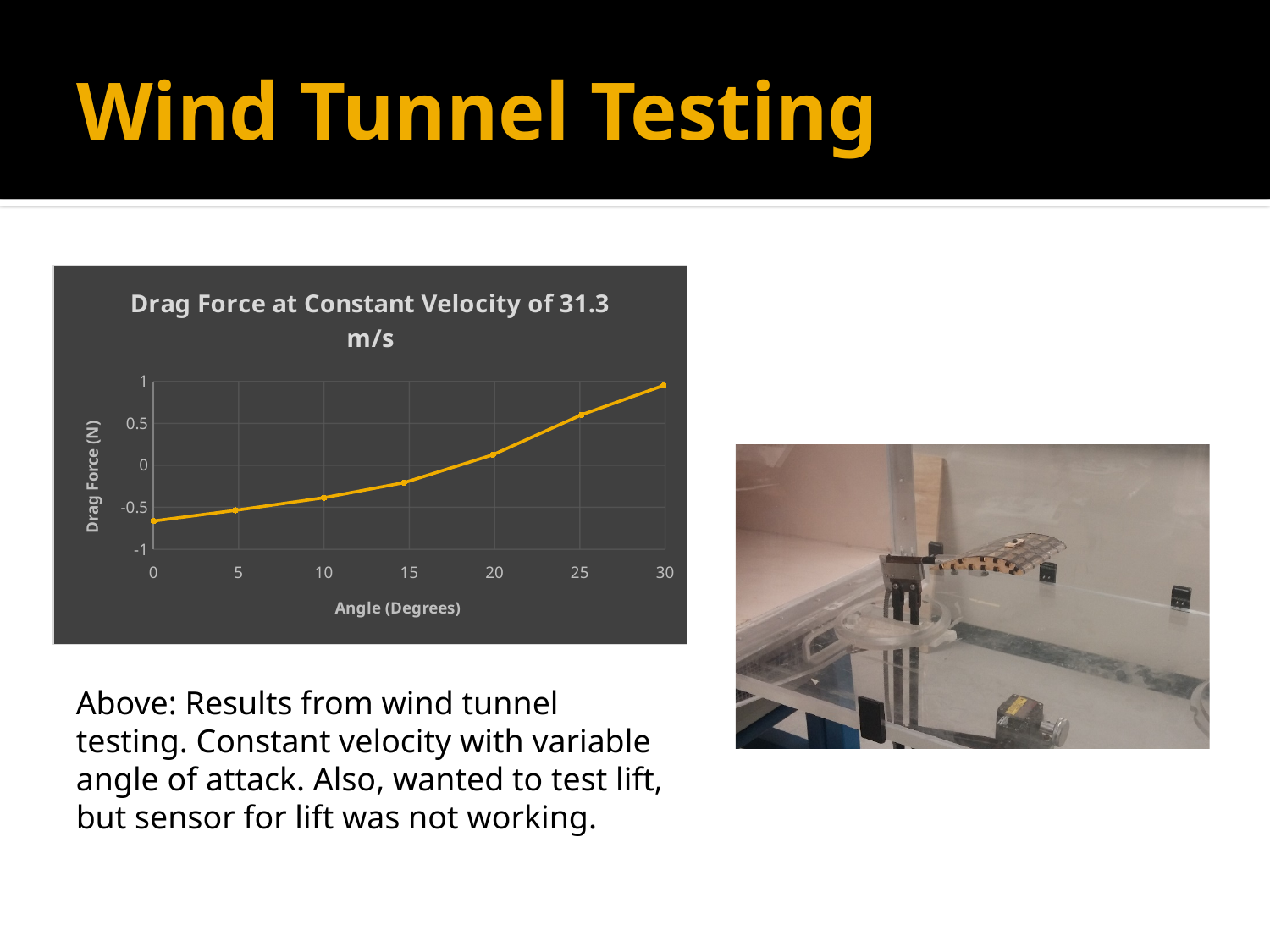
Is the drag force at 10 degrees greater or less than 0? less How many data points are plotted on the line? 7 Does the drag force rise or fall as the angle increases from 0 to 30 degrees? rise What is the label of the y axis of the chart? Drag Force (N) Is the drag force at 0 degrees greater or less than -0.5? less At which angle is the drag force highest? 30 Is the drag force at 30 degrees greater or less than 0.5? greater Which has the larger drag force, 5 degrees or 25 degrees? 25 degrees At which angle is the drag force lowest? 0 What is the title of the chart? Drag Force at Constant Velocity of 31.3 m/s What kind of chart is shown on the slide? line chart